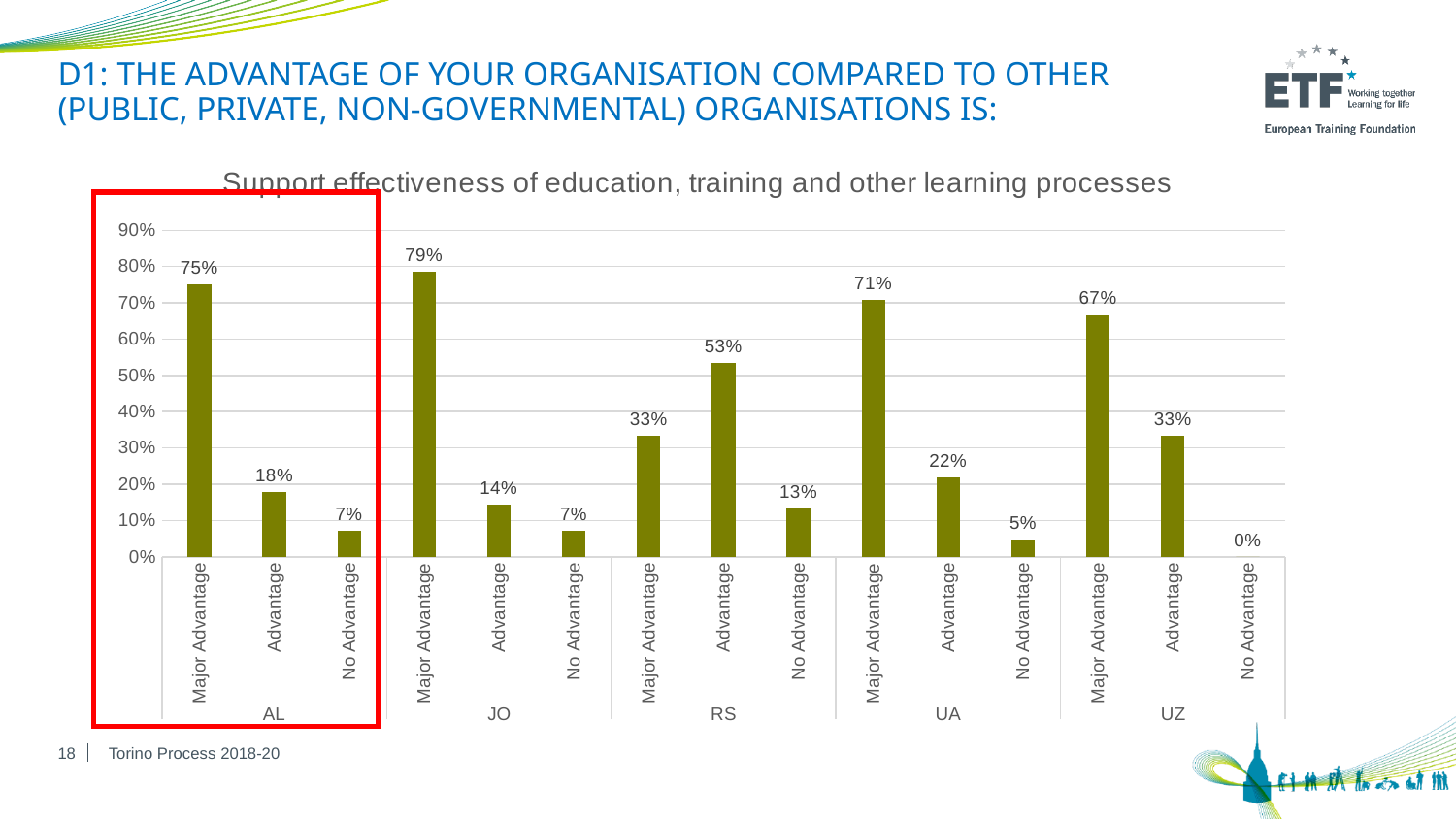
What is the value for No Advantage in UZ? 0% What is the difference between Major Advantage and Advantage in UA? 49% Which country has the highest Major Advantage value? JO What is the value for Advantage in RS? 53% What is the chart's title? Support effectiveness of education, training and other learning processes What kind of chart is this? Bar chart What is the value for Major Advantage in AL? 75% Which is larger: Advantage in RS or Advantage in UZ? Advantage in RS Which country has the lowest Major Advantage value? RS How many countries are shown on the x axis? 5 Which country's bars are outlined with a red box? AL What is the total of the three values for JO? 100%